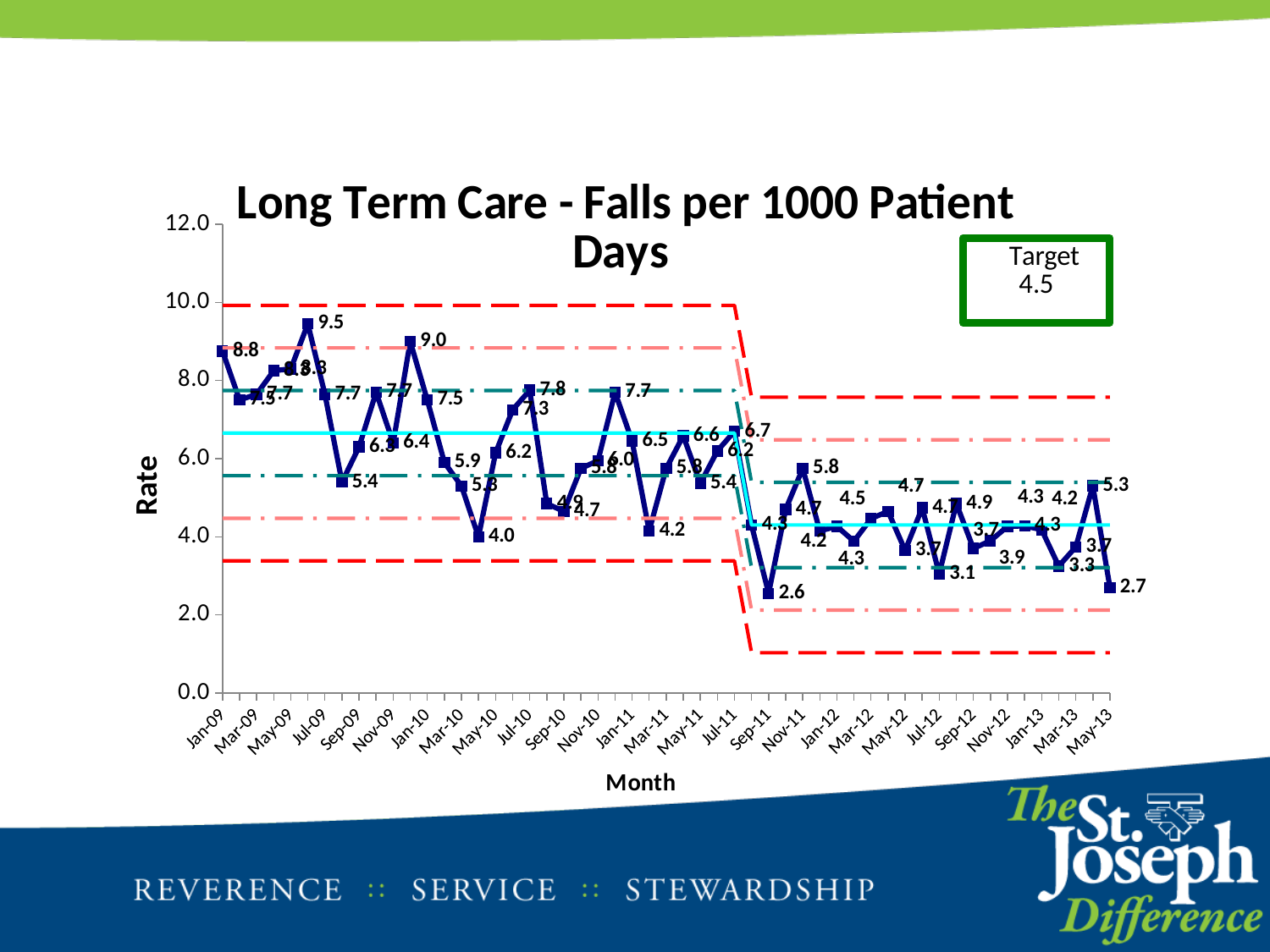
What kind of chart is shown on the slide? line chart Which month has the lowest falls rate in the chart? Sep-11 Is the falls rate for Nov-11 greater or less than 4.0? greater Which month has a higher falls rate, Jan-10 or May-10? Jan-10 What is the difference between the falls rate in Jul-09 and in Sep-11? 6.9 Which month has the highest falls rate in the chart? Jun-09 Overall, does the falls rate rise or fall from Jan-09 to May-13? fall What is the falls rate for Sep-11? 2.6 What is the falls rate for Jan-09? 8.8 What is the falls rate for May-13? 2.7 What target value is shown in the box on the chart? 4.5